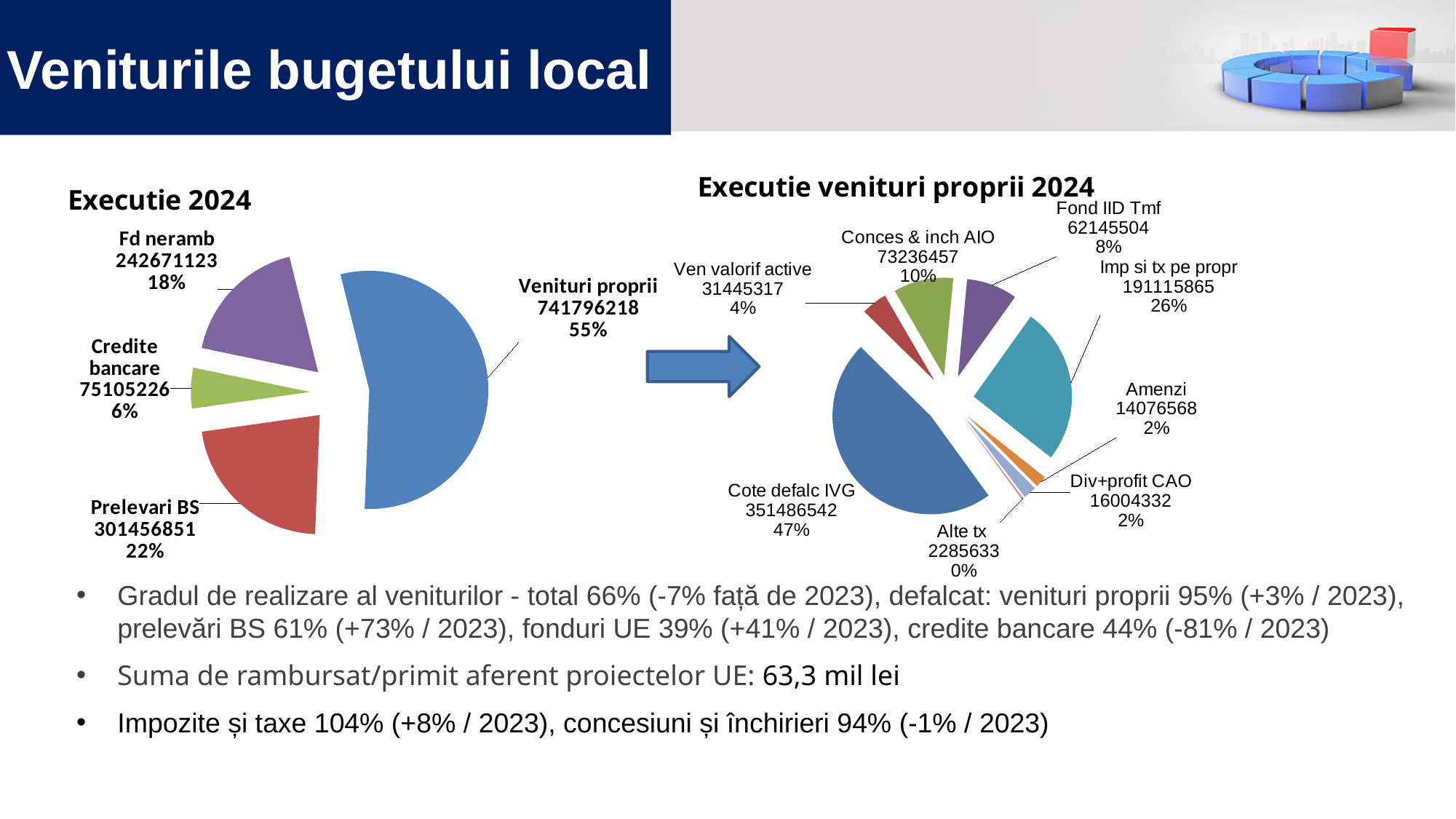
In the "Executie 2024" chart, how many categories are shown? 4 In the "Executie venituri proprii 2024" chart, which category is the smallest? Alte tx In the "Executie 2024" chart, which category is the smallest? Credite bancare In the "Executie venituri proprii 2024" chart, what share of the pie is Ven valorif active? 4% In the "Executie 2024" chart, what is the value for Venituri proprii? 741796218 What type of chart is the "Executie 2024" chart? pie chart In the "Executie venituri proprii 2024" chart, which category is the largest? Cote defalc IVG In the "Executie venituri proprii 2024" chart, how many categories are shown? 8 In the "Executie venituri proprii 2024" chart, which is larger, Conces & inch AIO or Fond IID Tmf? Conces & inch AIO In the "Executie 2024" chart, what is the difference between Fd neramb and Credite bancare? 167565897 In the "Executie venituri proprii 2024" chart, what is the value for Imp si tx pe propr? 191115865 In the "Executie 2024" chart, what share of the pie is Prelevari BS? 22%